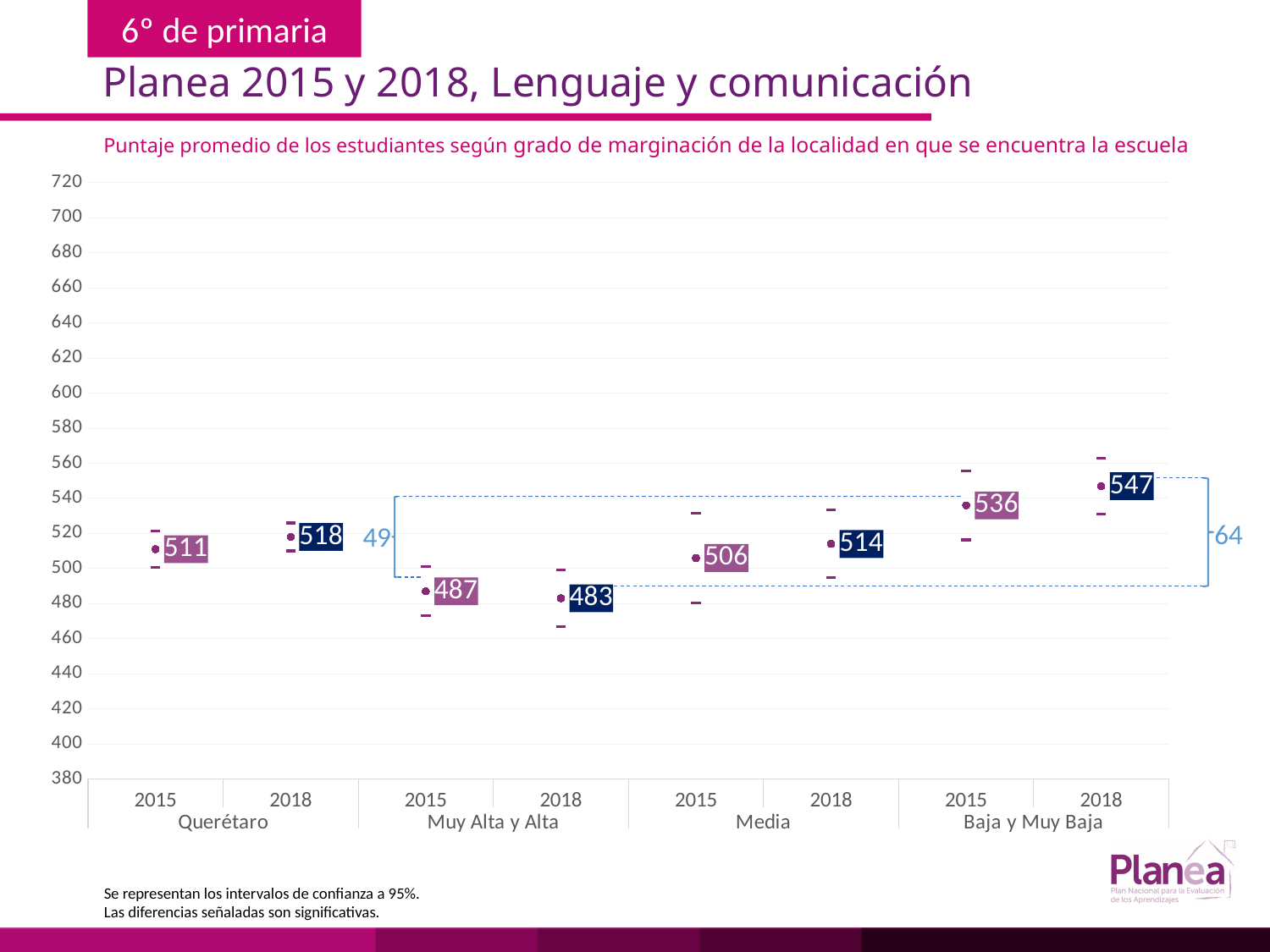
What is the average score for the Baja y Muy Baja group in 2018? 547 What is the average score for the Muy Alta y Alta marginalization group in 2018? 483 How many data points are plotted on the chart? 8 What is the average score for Querétaro in 2015? 511 What is the difference between the 2018 and 2015 scores for the Media group? 8 What is the subtitle of the chart? Puntaje promedio de los estudiantes según grado de marginación de la localidad en que se encuentra la escuela Did the score for the Muy Alta y Alta group rise or fall from 2015 to 2018? fall Which group and year has the lowest average score? Muy Alta y Alta, 2018 Which is larger, the 2015 score for Querétaro or the 2015 score for the Media group? Querétaro 2015 What is the difference between the 2018 and 2015 scores for the Baja y Muy Baja group? 11 Which group and year has the highest average score? Baja y Muy Baja, 2018 What is the average score for the Media group in 2015? 506